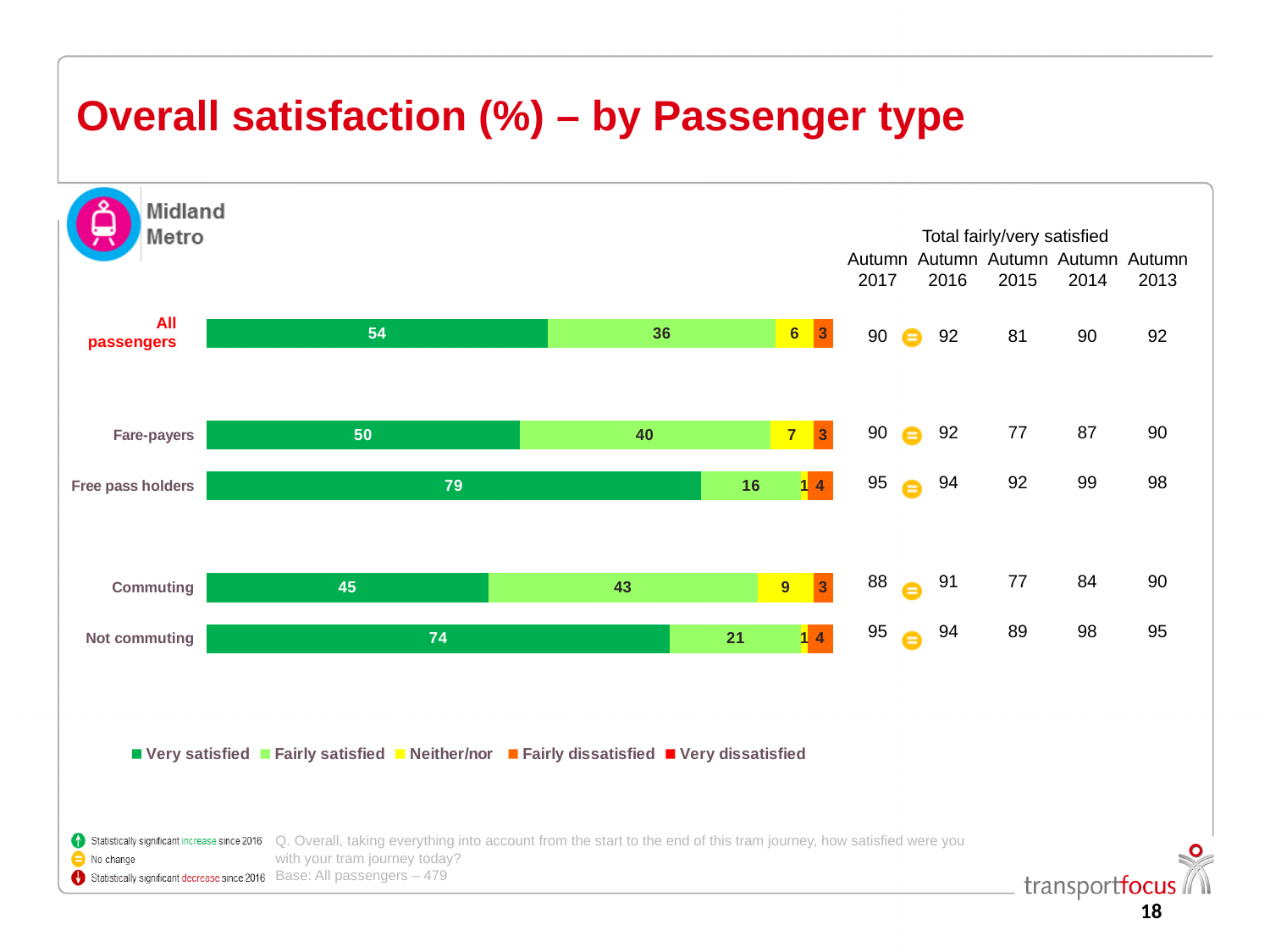
What is the combined Very satisfied and Fairly satisfied value for All passengers? 90 What kind of chart is shown on the slide? Stacked bar chart What is the title of the slide? Overall satisfaction (%) – by Passenger type What is the Fairly satisfied value for Commuting passengers? 43 Which passenger type has the highest Very satisfied value? Free pass holders Which has a larger Fairly satisfied value, Fare-payers or All passengers? Fare-payers Which passenger type has the lowest Very satisfied value? Commuting How many series does the legend list? 5 How many passenger types are shown in the chart? 5 What is the Neither/nor value for Fare-payers? 7 What is the difference between the Very satisfied values for Free pass holders and Not commuting? 5 What is the Very satisfied value for Free pass holders? 79